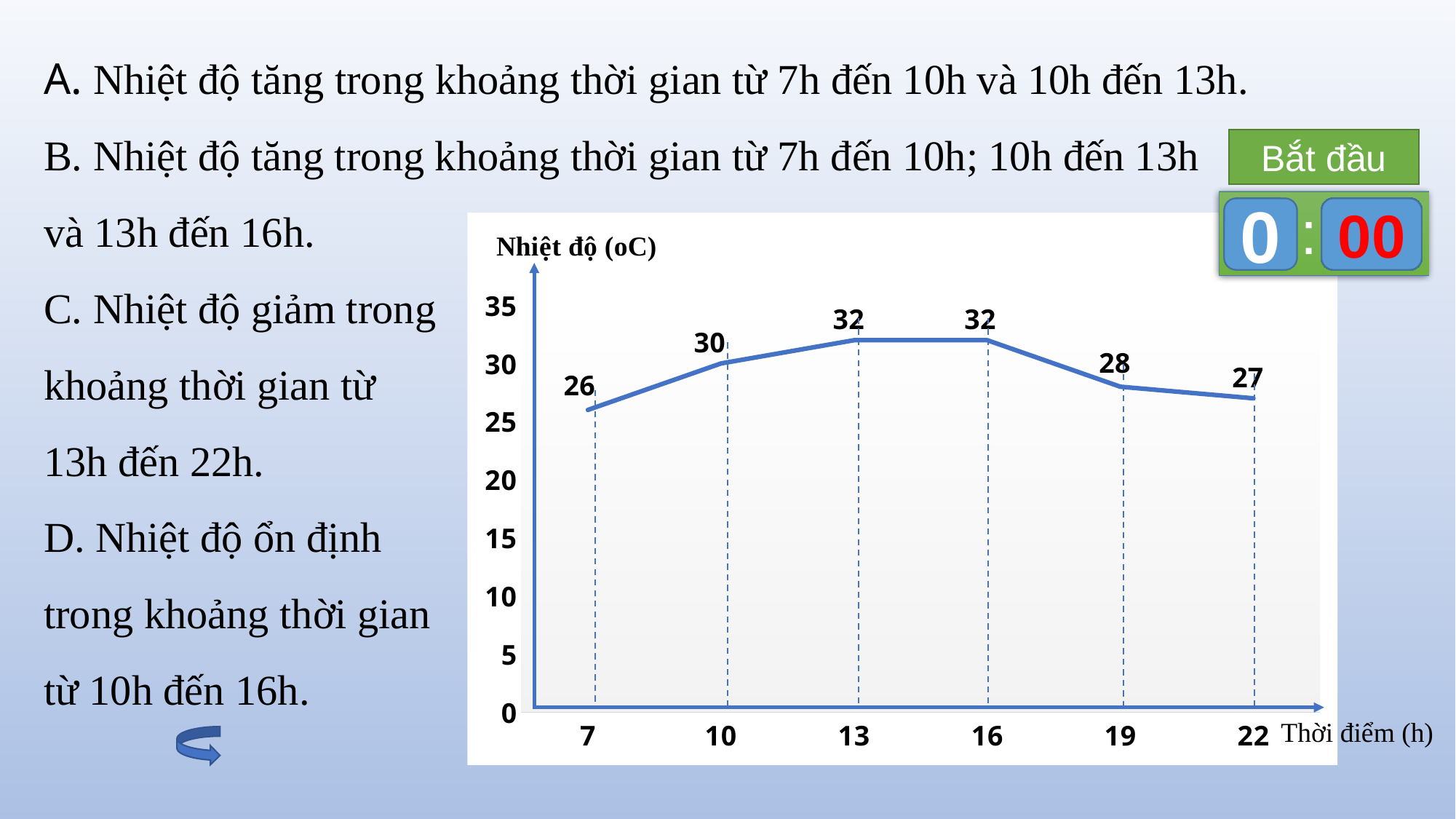
Does the temperature rise or fall from 16h to 22h? fall How many time points are plotted on the chart? 6 What is the label of the vertical axis of the chart? Nhiệt độ (oC) At which time point is the temperature lowest? 7 What is the temperature at 19h? 28 What is the difference between the temperature at 16h and the temperature at 22h? 5 What kind of chart is shown on the slide? line chart Which is larger, the temperature at 10h or the temperature at 19h? 10h What is the highest temperature value shown on the chart? 32 What is the difference between the temperature at 13h and the temperature at 7h? 6 What is the temperature at 7h? 26 What is the temperature at 22h? 27